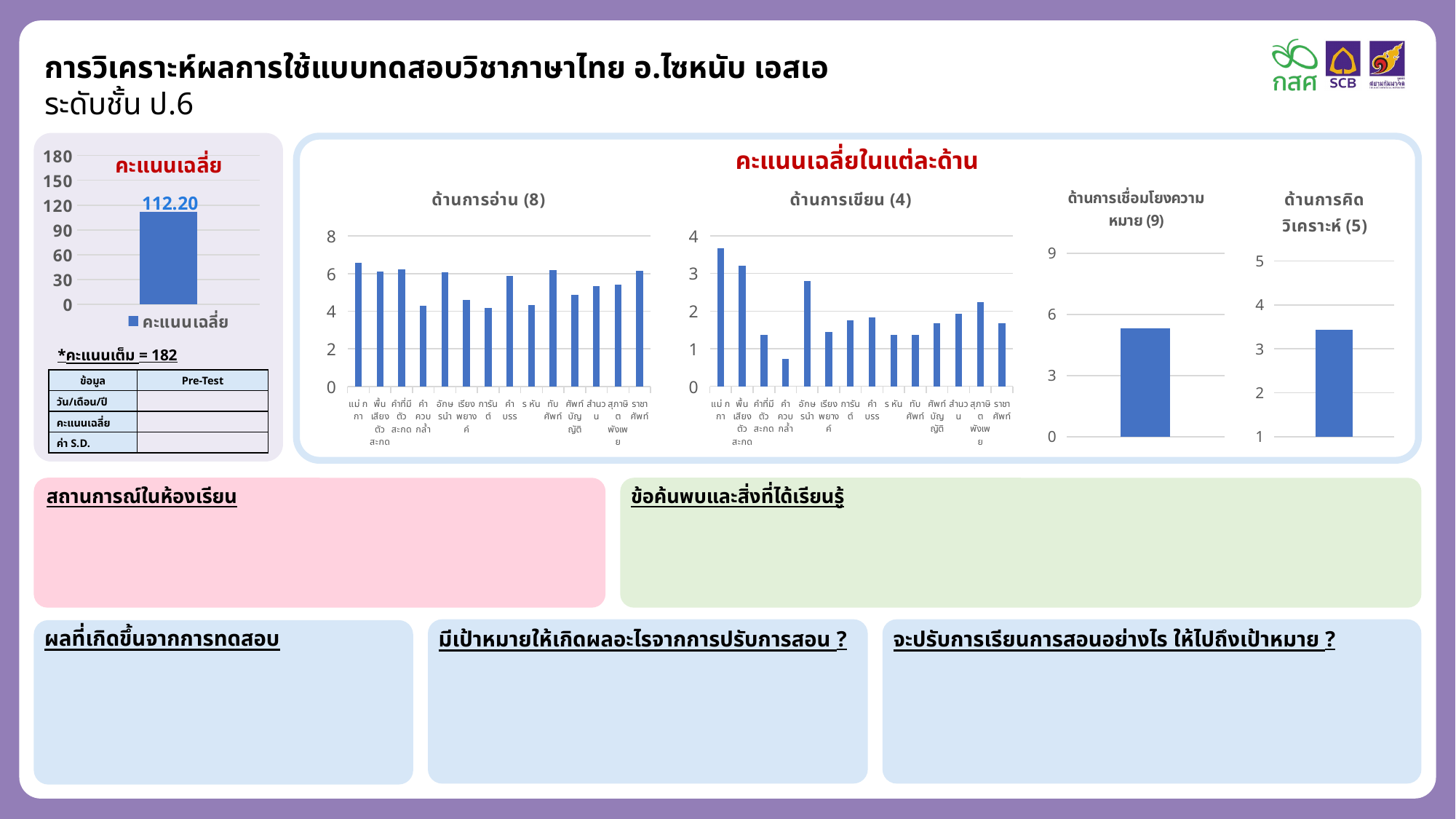
In the chart titled ด้านการอ่าน (8), how many categories are plotted? 14 In the chart titled ด้านการอ่าน (8), is the value for แม่ ก กา greater or less than 6? greater How many charts are shown inside the panel titled คะแนนเฉลี่ยในแต่ละด้าน? 4 What kind of chart is the คะแนนเฉลี่ย chart on the left? bar chart In the chart titled ด้านการเขียน (4), which category has the lowest value? คำควบกล้ำ In the chart titled ด้านการเขียน (4), which category has the highest value? แม่ ก กา In the chart titled คะแนนเฉลี่ย on the left, what value is shown for the bar? 112.20 In the chart titled คะแนนเฉลี่ย on the left, what entry does the legend show? คะแนนเฉลี่ย In the chart titled ด้านการคิดวิเคราะห์ (5), is the value of the bar greater or less than 3? greater In the chart titled ด้านการเชื่อมโยงความหมาย (9), is the value of the bar greater or less than 6? less In the chart titled ด้านการอ่าน (8), which is larger, the value for อักษรนำ or the value for เรียงพยางค์? อักษรนำ